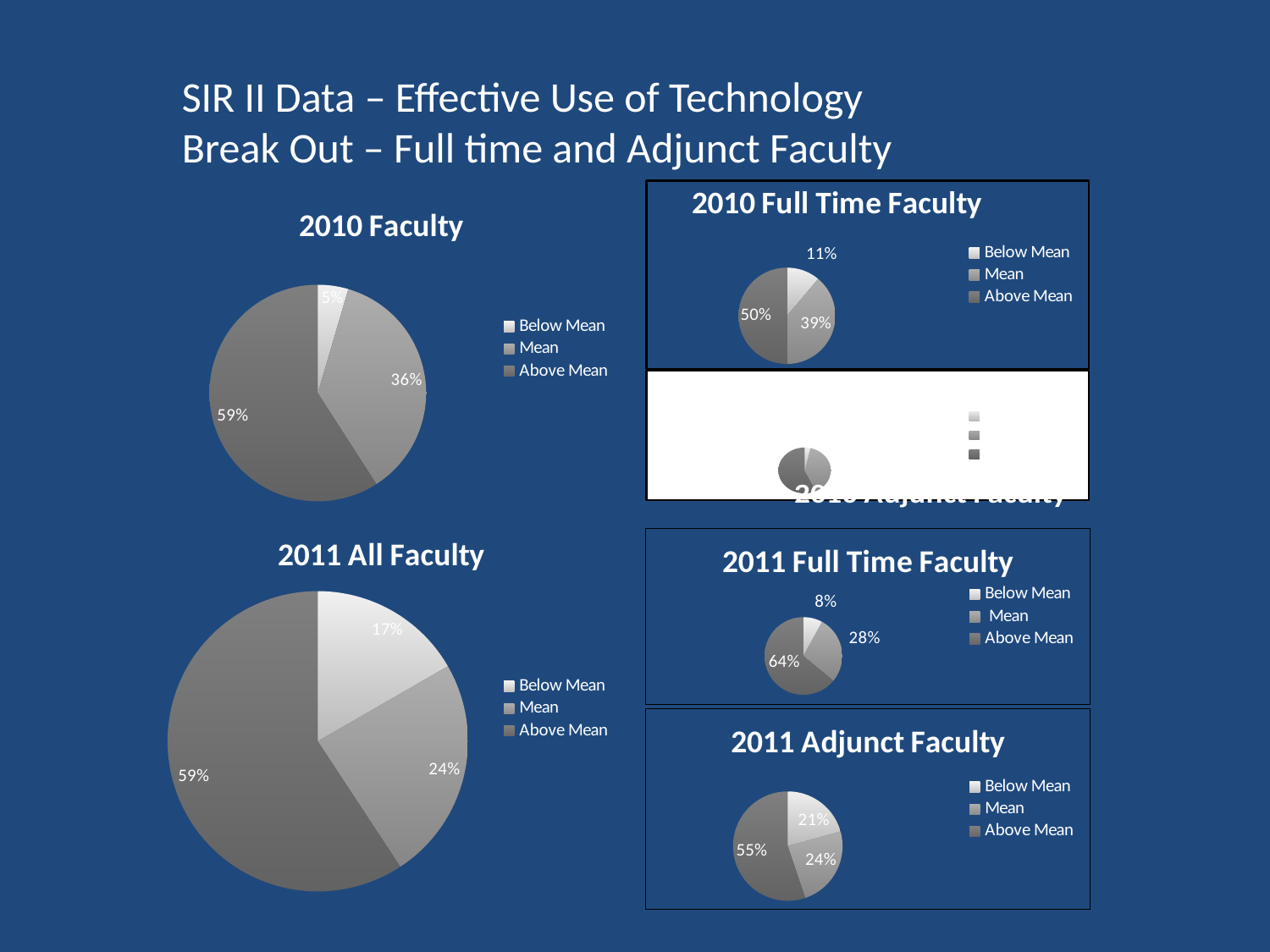
How many entries does the legend of the 2011 Adjunct Faculty chart list? 3 In the 2010 Full Time Faculty chart, what is the value for Mean? 39% In the 2011 Full Time Faculty chart, what is the difference between the Above Mean and Mean slices? 36% In the 2011 Full Time Faculty chart, what is the value for Above Mean? 64% In the 2011 Adjunct Faculty chart, what is the value for Mean? 24% In the 2010 Faculty chart, what share of the pie is Above Mean? 59% What type of chart is the 2011 All Faculty chart? Pie chart In the 2010 Full Time Faculty chart, which category has the largest slice? Above Mean In the 2011 All Faculty chart, what is the value for Below Mean? 17% In the 2010 Faculty chart, what percentage is Below Mean? 5% In the 2011 All Faculty chart, which category has the smallest slice? Below Mean In the 2011 Adjunct Faculty chart, which is larger, Below Mean or Above Mean? Above Mean